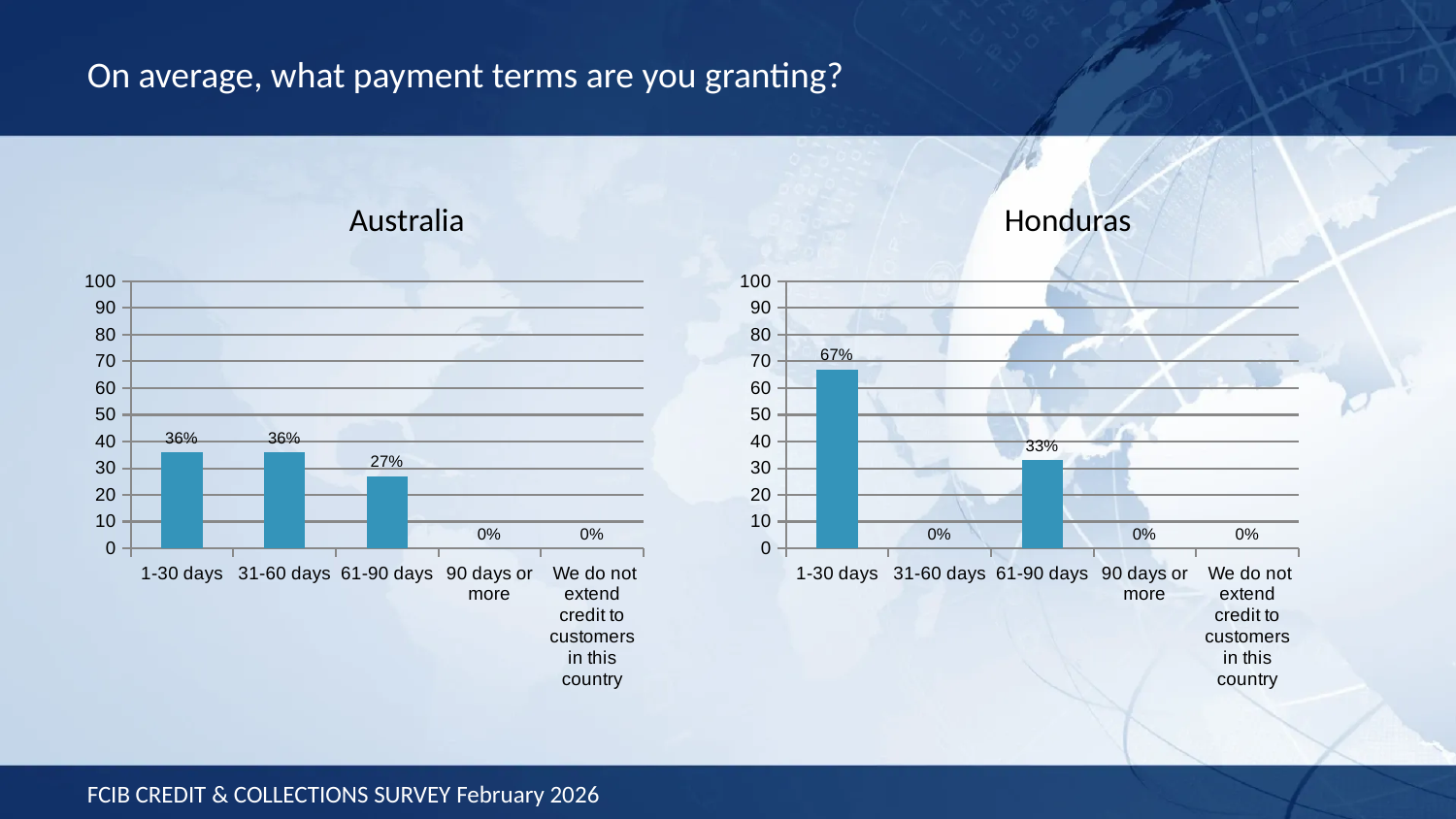
In the Honduras chart, which category has the highest value? 1-30 days Which is larger in the Honduras chart: the value for 1-30 days or the value for 61-90 days? 1-30 days In the Honduras chart, what is the value for 1-30 days? 67% In the Australia chart, what is the difference between the 1-30 days value and the 61-90 days value? 9% In the Honduras chart, what is the value for 61-90 days? 33% In the Australia chart, what is the value for 1-30 days? 36% In the Honduras chart, what is the difference between the 1-30 days value and the 61-90 days value? 34% In the Australia chart, what is the value for 61-90 days? 27% In the Australia chart, is the value for 61-90 days greater or less than 30? less What kind of chart is the Honduras chart? bar chart In the Australia chart, what is the value for 90 days or more? 0% How many categories are shown on the x axis of the Australia chart? 5